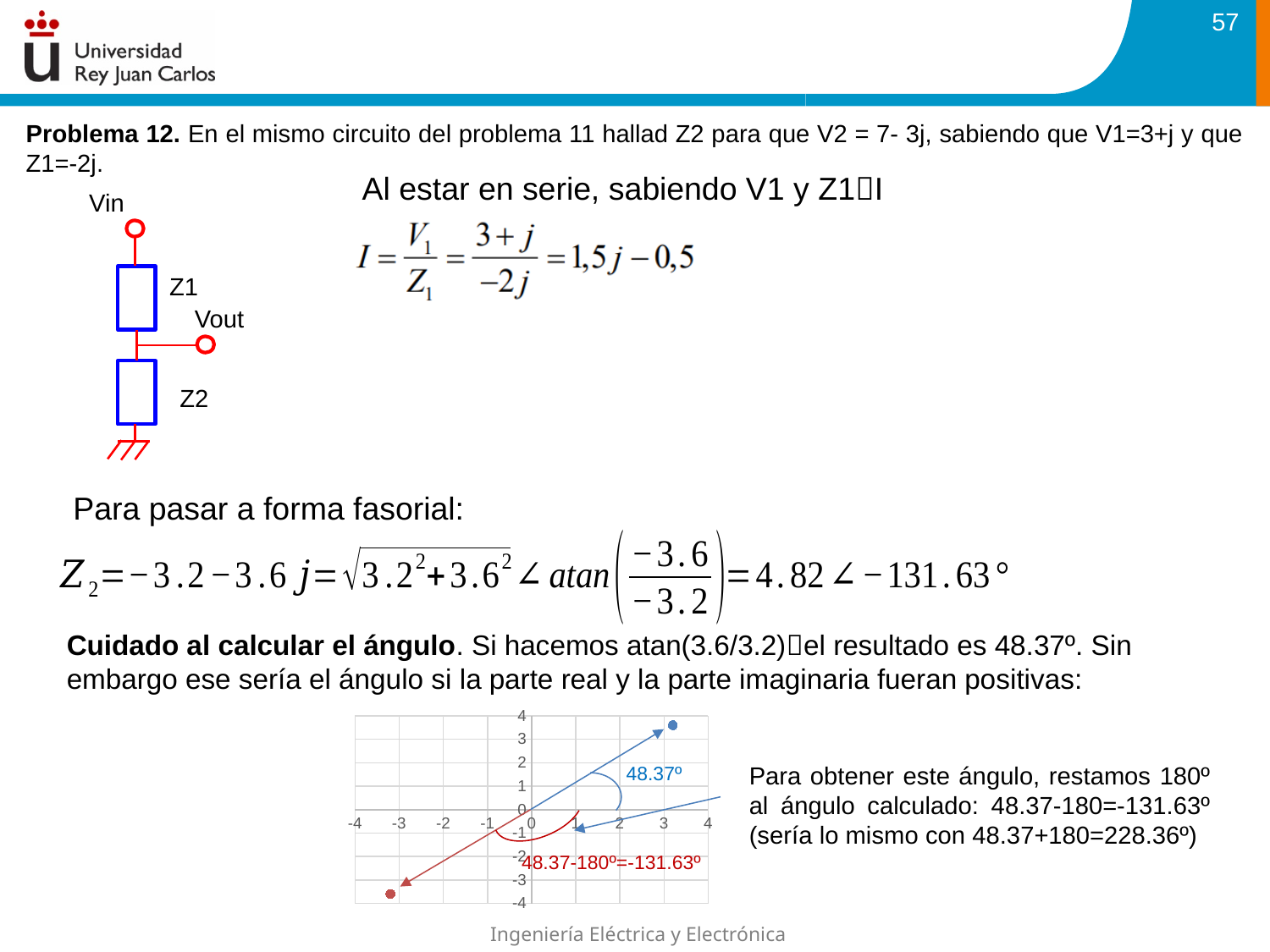
On the chart at the bottom of the slide, in which quadrant does the red point lie? the lower-left (third) quadrant How many data points are plotted on the chart at the bottom of the slide? 2 On the chart at the bottom of the slide, is the vertical-axis value of the blue point greater or less than 2? greater What is the maximum value shown on the vertical axis of the chart at the bottom of the slide? 4 On the chart at the bottom of the slide, is the horizontal-axis value of the blue point greater or less than 2? greater On the chart at the bottom of the slide, is the vertical-axis value of the red point greater or less than -2? less What kind of chart is shown at the bottom of the slide? scatter chart On the chart at the bottom of the slide, which point is higher on the vertical axis, the blue point or the red point? the blue point What angle label is written in blue next to the upper arc on the chart at the bottom of the slide? 48.37º